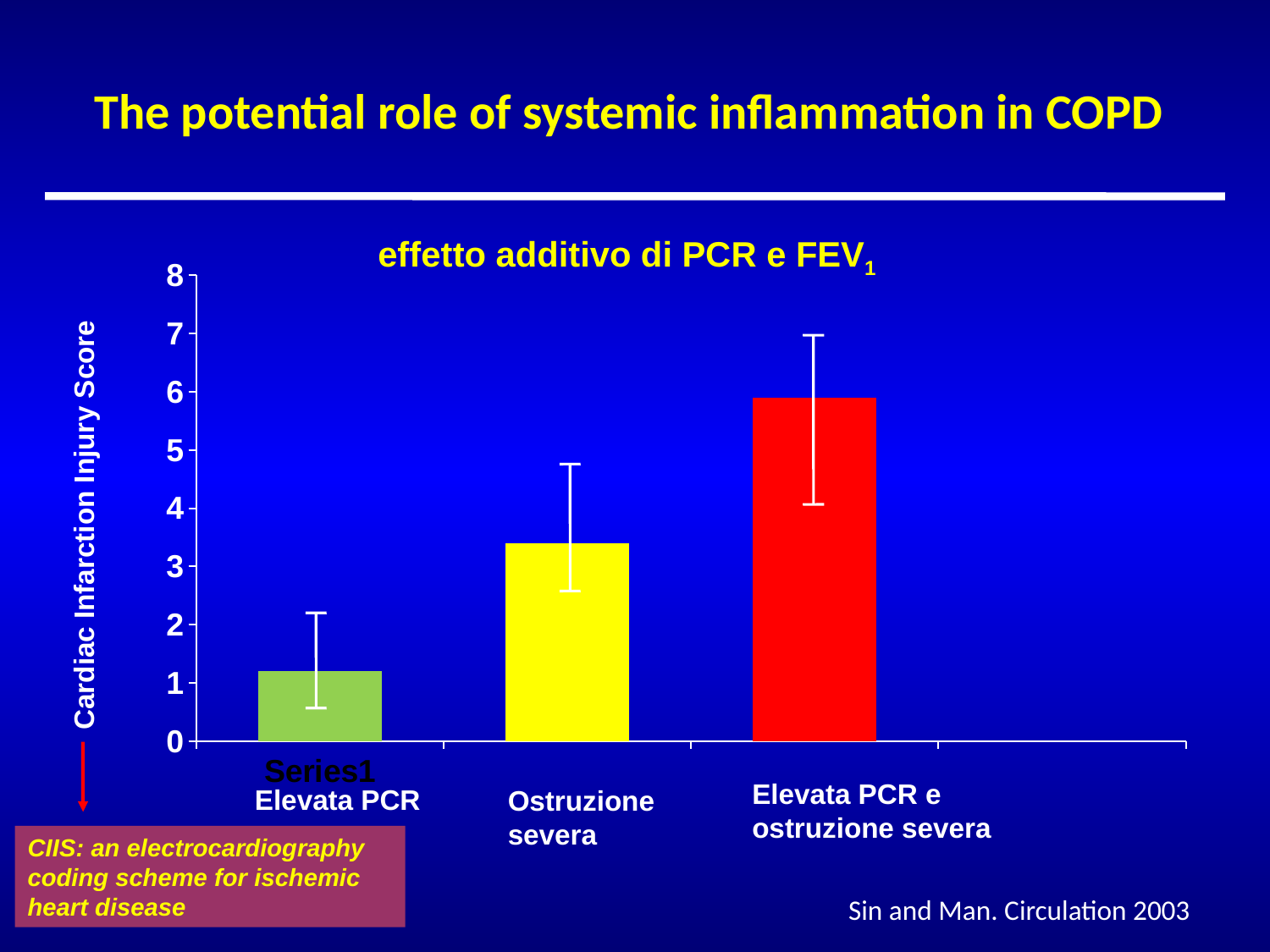
Which category has the highest Cardiac Infarction Injury Score? Elevata PCR e ostruzione severa What is the title of the chart? effetto additivo di PCR e FEV1 Is the value for Elevata PCR e ostruzione severa greater or less than 5? greater Is the value for Ostruzione severa greater or less than 3? greater Which category has the lowest Cardiac Infarction Injury Score? Elevata PCR What is the highest value shown on the vertical axis? 8 How many bars are plotted in the chart? 3 What kind of chart is shown on the slide? bar chart Which is larger, the value for Ostruzione severa or the value for Elevata PCR? Ostruzione severa What is the label of the vertical axis? Cardiac Infarction Injury Score Do the bar values rise or fall from left to right across the categories? rise Is the value for Elevata PCR greater or less than 2? less